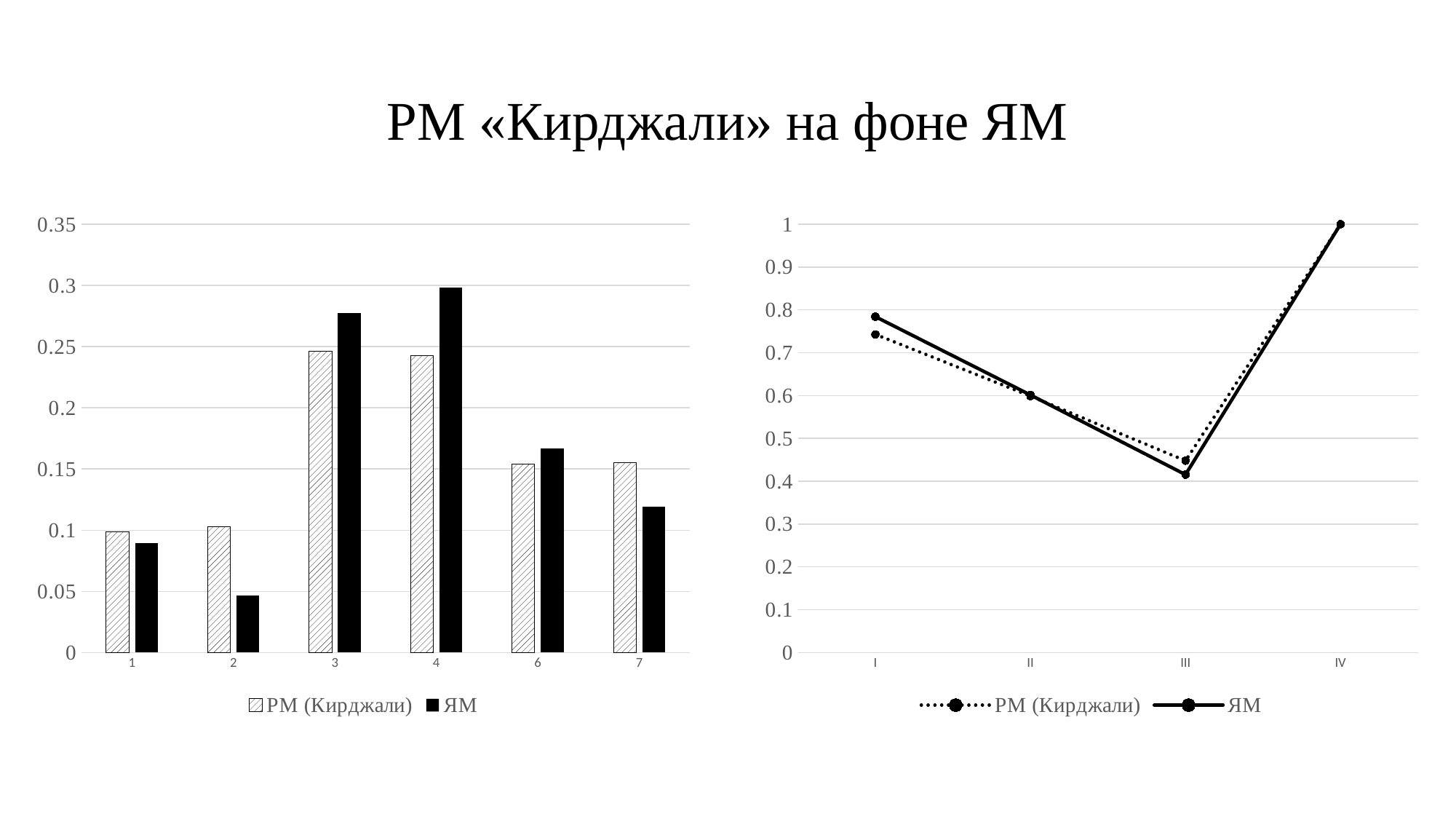
In the left bar chart, is the value for ЯМ at category 1 greater or less than 0.1? less In the left bar chart, is the value for ЯМ at category 7 greater or less than 0.1? greater In the left bar chart, which category has the highest value for ЯМ? 4 What kind of chart is the chart on the right side of the slide? line chart In the right line chart, at which category does ЯМ reach its lowest value? III In the left bar chart, which is larger at category 4: РМ (Кирджали) or ЯМ? ЯМ What kind of chart is the chart on the left side of the slide? bar chart In the right line chart, how many series does the legend list? 2 In the left bar chart, how many categories are shown on the x axis? 6 In the left bar chart, which category has the lowest value for ЯМ? 2 In the right line chart, what is the value of ЯМ at IV? 1 In the right line chart, is the value for РМ (Кирджали) at III greater or less than 0.5? less